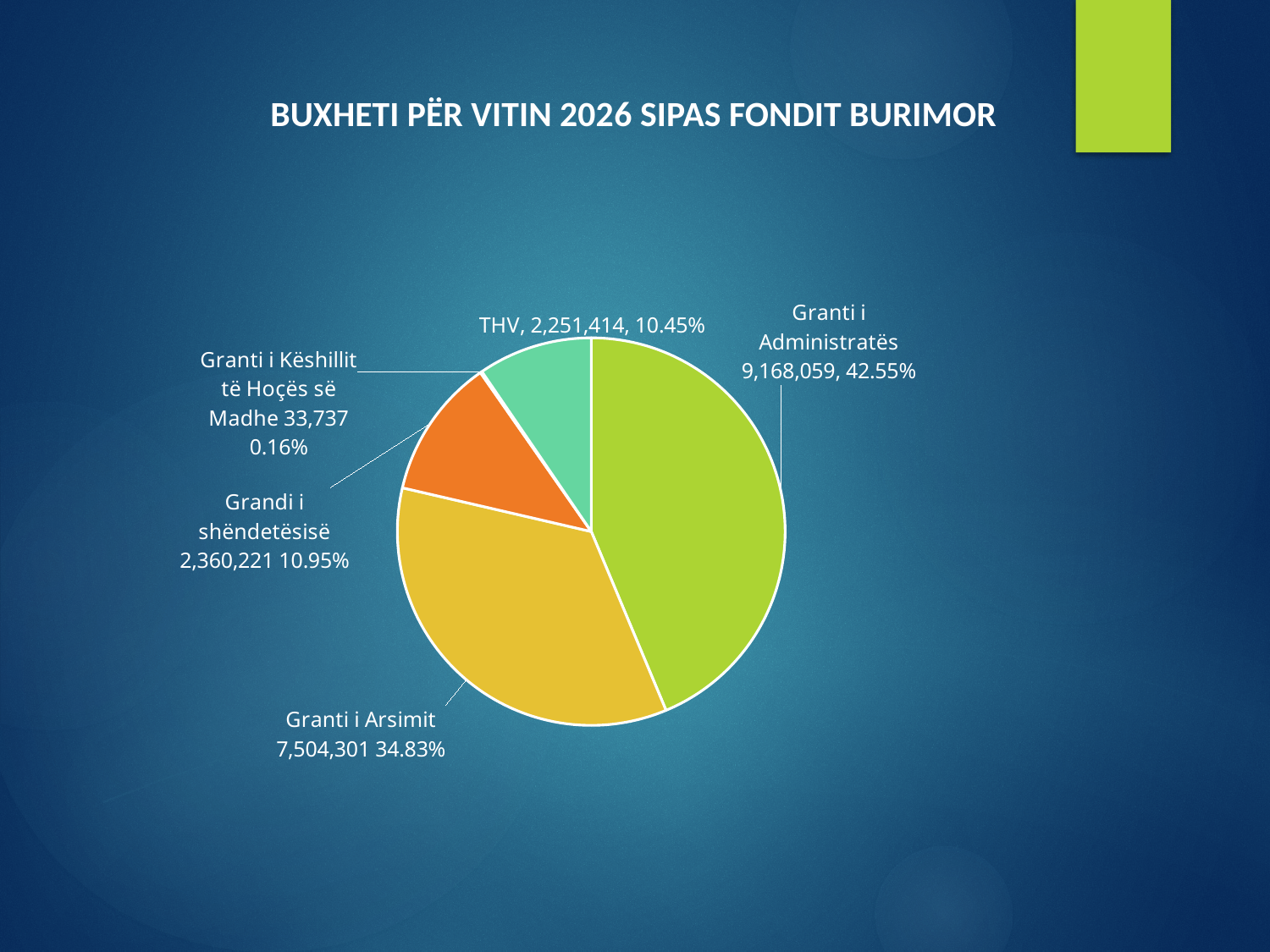
What is the value for Granti i Këshillit të Hoçës së Madhe? 33,737 What share of the pie does Grandi i shëndetësisë represent? 10.95% What is the value for THV? 2,251,414 What is the title of the chart? BUXHETI PËR VITIN 2026 SIPAS FONDIT BURIMOR How many slices does the pie chart have? 5 What is the value for Granti i Arsimit? 7,504,301 What is the difference between the values for Granti i Administratës and Granti i Arsimit? 1,663,758 What kind of chart is shown on the slide? pie chart What is the value for Granti i Administratës? 9,168,059 Which category has the smallest slice? Granti i Këshillit të Hoçës së Madhe Which category has the largest slice? Granti i Administratës What share of the pie does Granti i Arsimit represent? 34.83%